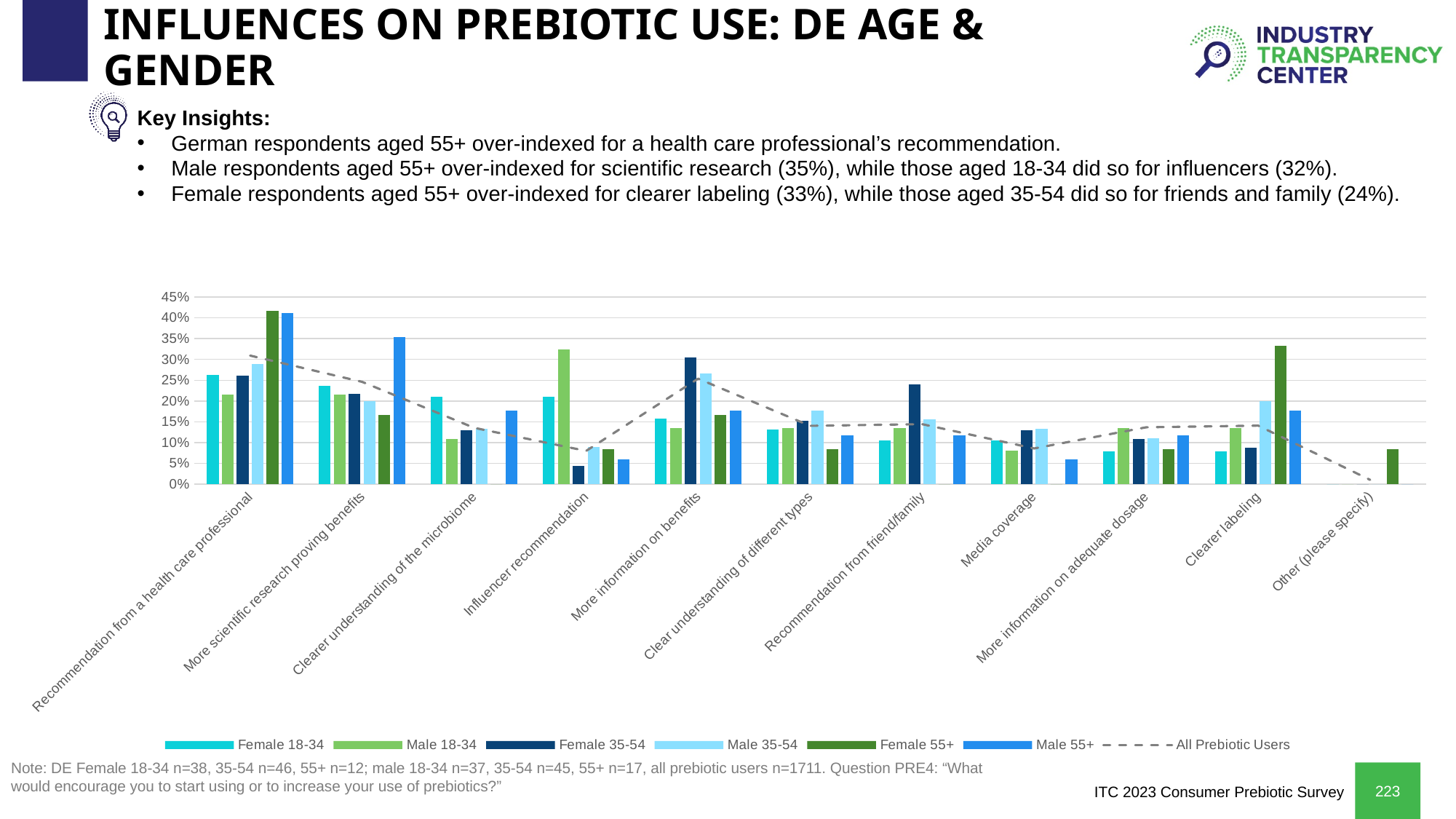
Is the Male 18-34 value for Influencer recommendation greater or less than 25%? greater How many categories are shown along the x axis of the chart? 11 Which category has the highest Female 55+ bar? Recommendation from a health care professional Which category has the highest Male 18-34 bar? Influencer recommendation Which category has the highest Female 35-54 bar? More information on benefits How many series does the chart legend list? 7 Is the Male 55+ value for Recommendation from a health care professional greater or less than 35%? greater Does the dashed All Prebiotic Users line rise or fall from Recommendation from a health care professional to Influencer recommendation? fall Is the Female 35-54 value for Influencer recommendation greater or less than 10%? less For Clearer labeling, which is larger: the Female 55+ bar or the Male 55+ bar? Female 55+ What does the dashed grey line in the chart represent? All Prebiotic Users What kind of chart is shown on the slide? bar and line chart